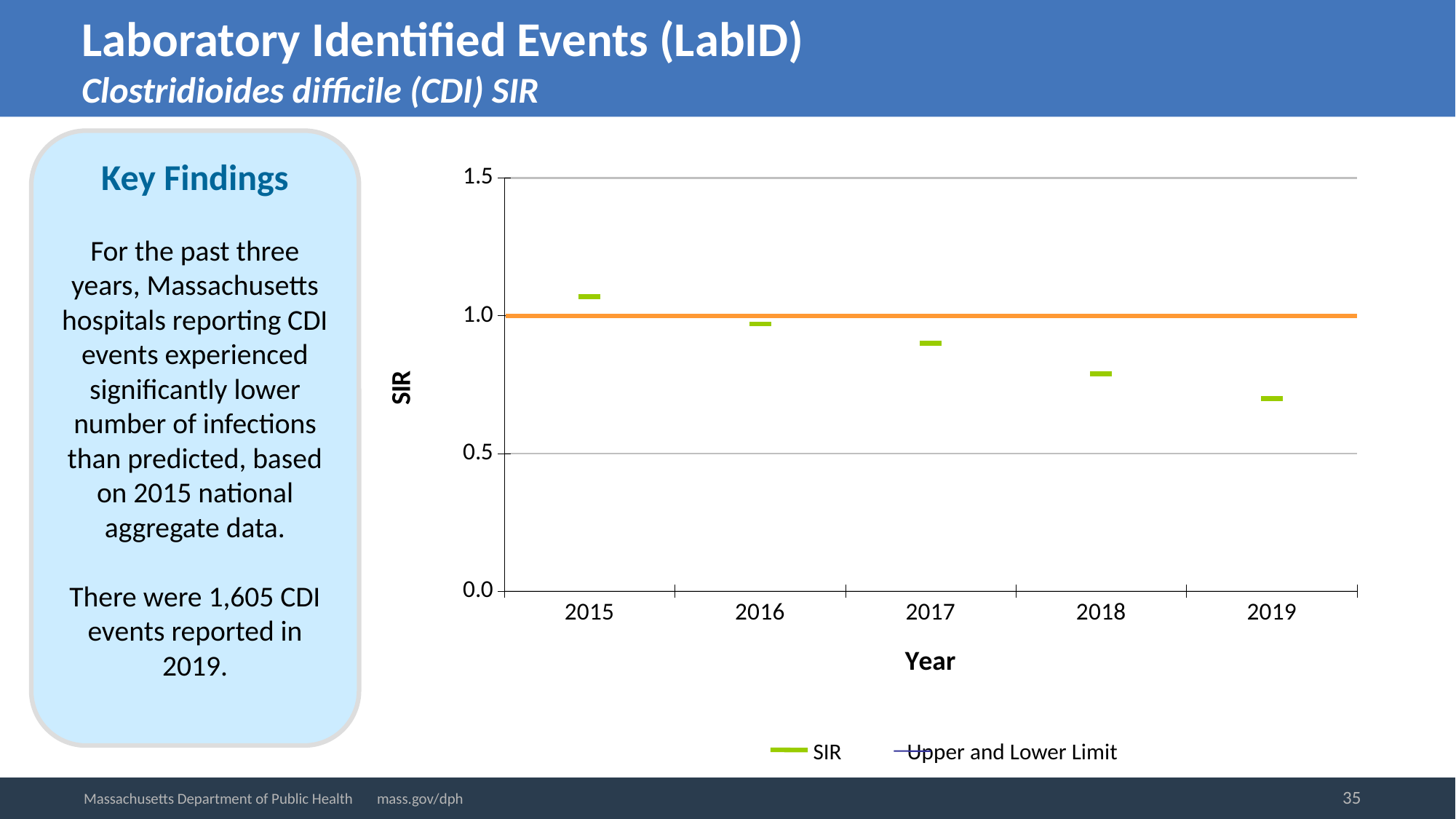
Which year has the lowest SIR value in the chart? 2019 Is the SIR value for 2017 greater or less than 1.0? less Is the SIR value for 2015 greater or less than 1.0? greater Do the SIR values rise or fall from 2015 to 2019? fall How many series does the chart legend list? 2 How many years are shown on the x axis of the chart? 5 Which year has the larger SIR value, 2015 or 2019? 2015 What is the label of the y axis of the chart? SIR Which year has the highest SIR value in the chart? 2015 Is the SIR value for 2019 greater or less than 1.0? less What are the two entries listed in the chart legend? SIR; Upper and Lower Limit